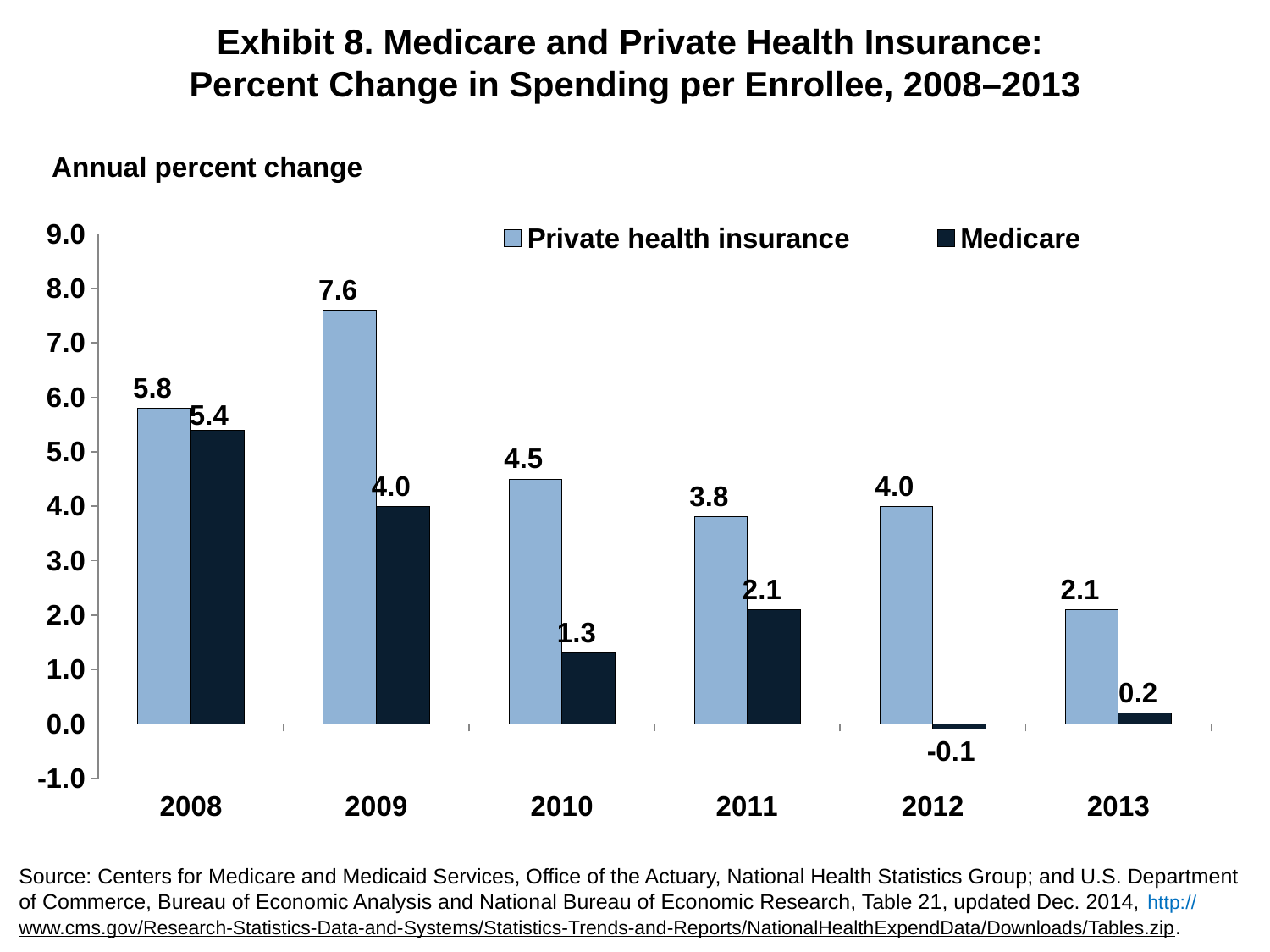
What is the value for Medicare in 2010? 1.3 What is the label on the y axis? Annual percent change What is the value for Private health insurance in 2009? 7.6 What is the difference between the Private health insurance and Medicare values in 2010? 3.2 How many years are shown on the x axis? 6 Which is larger in 2011, the Private health insurance value or the Medicare value? Private health insurance What is the value for Medicare in 2012? -0.1 In which year is the Private health insurance value highest? 2009 In which year is the Medicare value lowest? 2012 What kind of chart is this? Bar chart How many series does the legend list? 2 Does the Medicare value rise or fall from 2008 to 2010? Fall